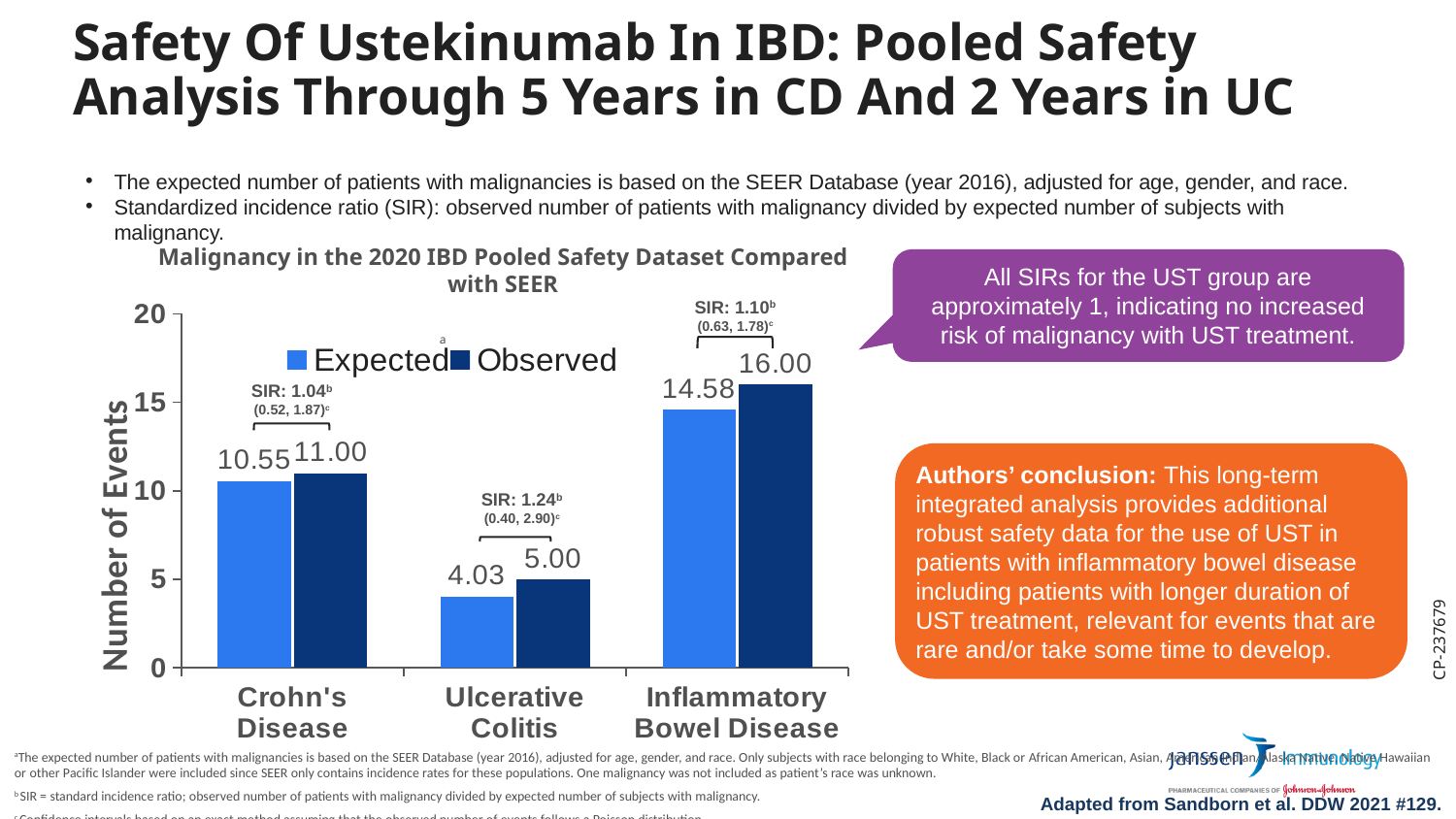
What type of chart is shown on the slide? bar chart How many series does the chart legend list? 2 What is the Observed number of events for Inflammatory Bowel Disease? 16.00 Which category has the highest Observed number of events? Inflammatory Bowel Disease What is the Expected number of events for Crohn's Disease? 10.55 What is the Observed number of events for Ulcerative Colitis? 5.00 What is the label of the y axis of the chart? Number of Events Which category has the lowest Expected number of events? Ulcerative Colitis What is the difference between the Observed and Expected number of events for Inflammatory Bowel Disease? 1.42 Is the Expected value for Ulcerative Colitis greater or less than 5? less Is the Observed number of events for Crohn's Disease larger or smaller than the Expected number? larger How many categories are shown on the x axis of the chart? 3